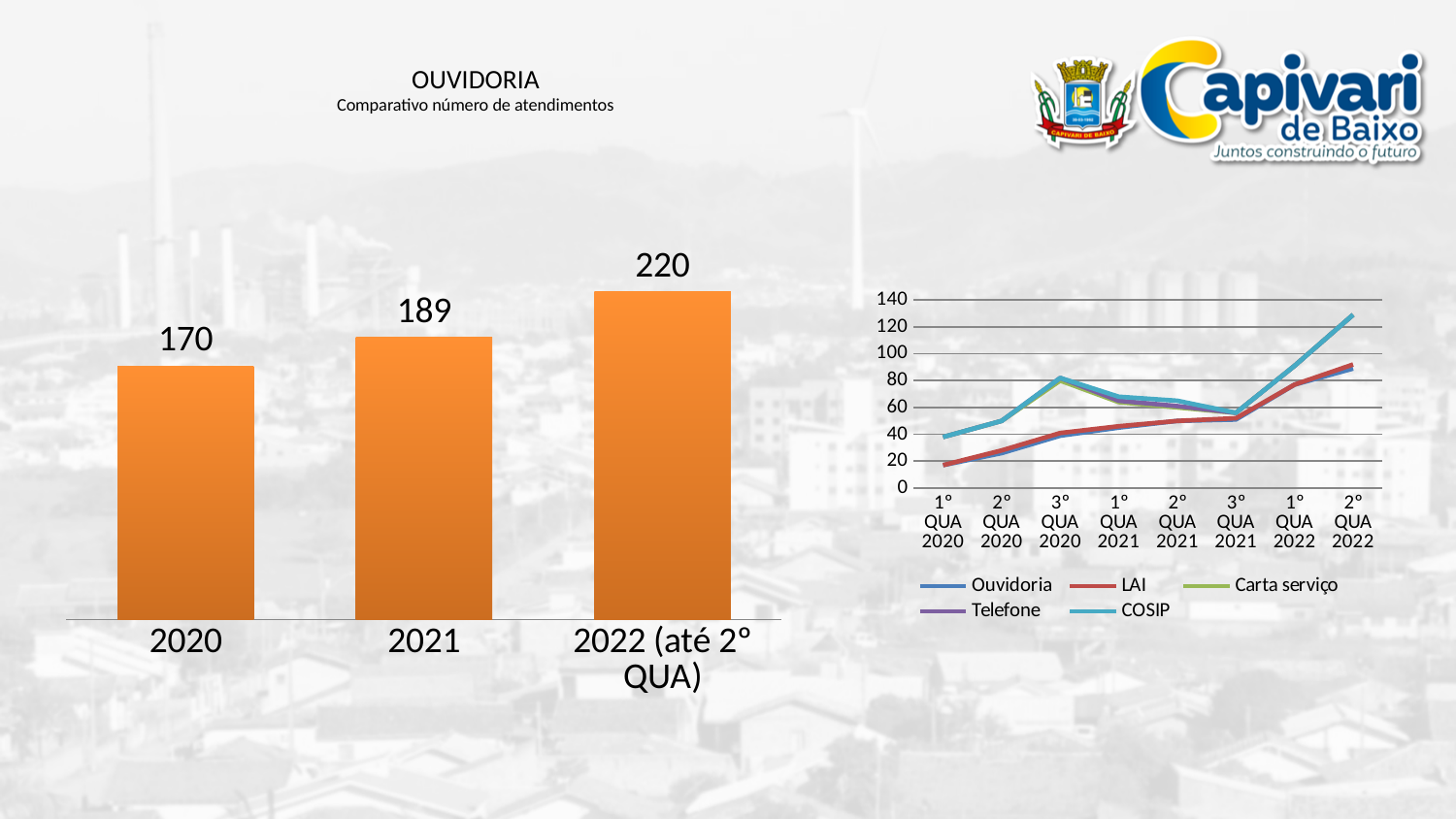
In the line chart on the right, is the value for COSIP at 2° QUA 2022 greater or less than 120? greater In the bar chart on the left, do the values rise or fall from 2020 to 2022 (até 2° QUA)? rise In the bar chart on the left, which category has the lowest value? 2020 In the bar chart on the left, what is the value for 2021? 189 How many points are on the x axis of the line chart on the right? 8 In the bar chart on the left, which category has the highest value? 2022 (até 2° QUA) In the line chart on the right, is the value for LAI at 1° QUA 2020 greater or less than 20? less In the bar chart on the left, what is the difference between the values for 2022 (até 2° QUA) and 2020? 50 How many series does the legend of the line chart on the right list? 5 In the bar chart on the left, what is the value for 2022 (até 2° QUA)? 220 What kind of chart is the chart on the left? bar chart In the bar chart on the left, what is the value for 2020? 170